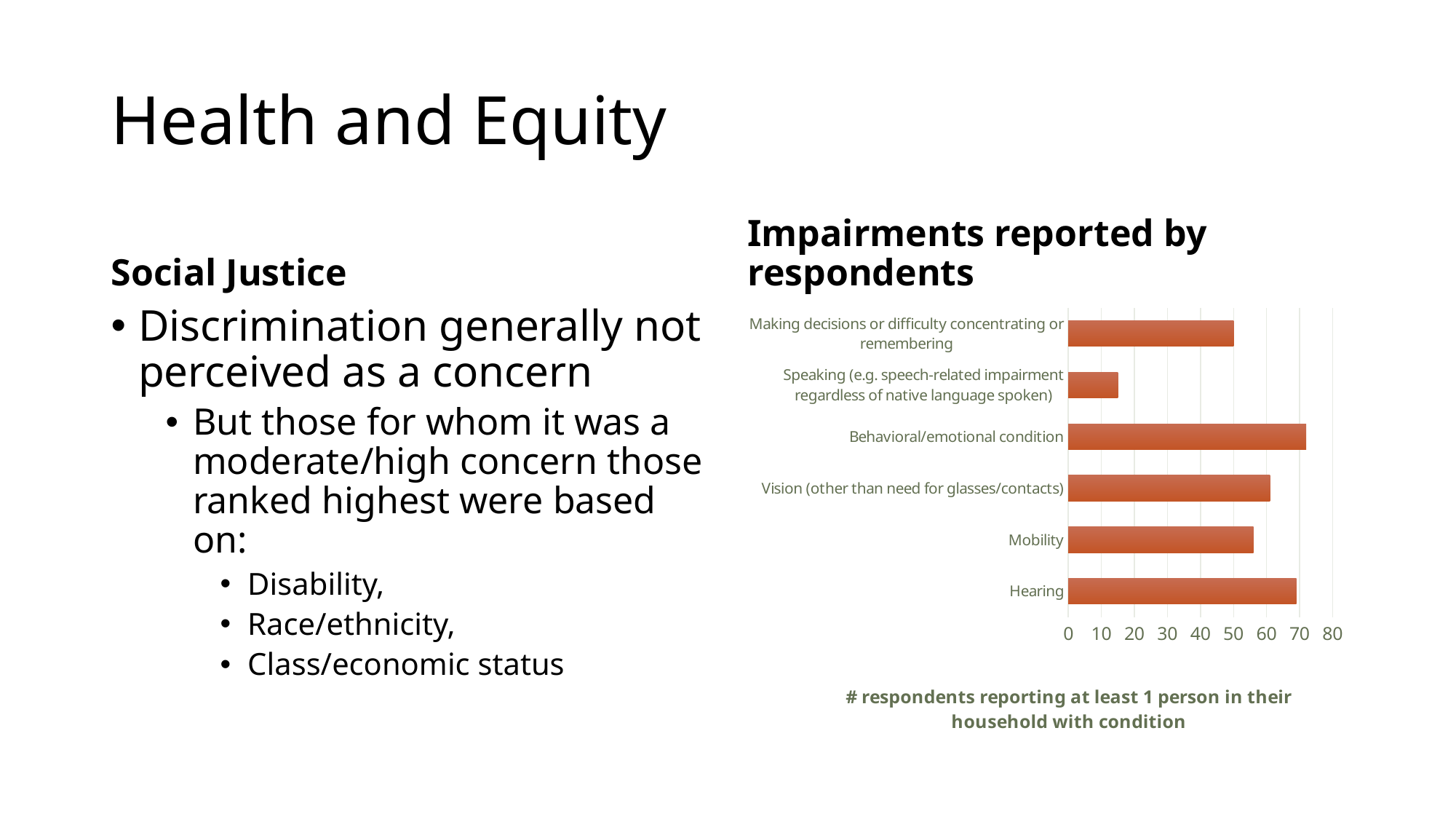
Is the value for Mobility greater or less than 60? less Is the value for Mobility greater or less than 50? greater Which impairment category has the lowest number of respondents in the chart? Speaking (e.g. speech-related impairment regardless of native language spoken) How many impairment categories are plotted in the "Impairments reported by respondents" chart? 6 Which has more respondents reporting it: Behavioral/emotional condition or Speaking? Behavioral/emotional condition Is the value for Hearing greater or less than 60? greater What kind of chart is shown under the title "Impairments reported by respondents"? Bar chart Which has more respondents reporting it: Hearing or Mobility? Hearing What is the axis label shown beneath the "Impairments reported by respondents" chart? # respondents reporting at least 1 person in their household with condition